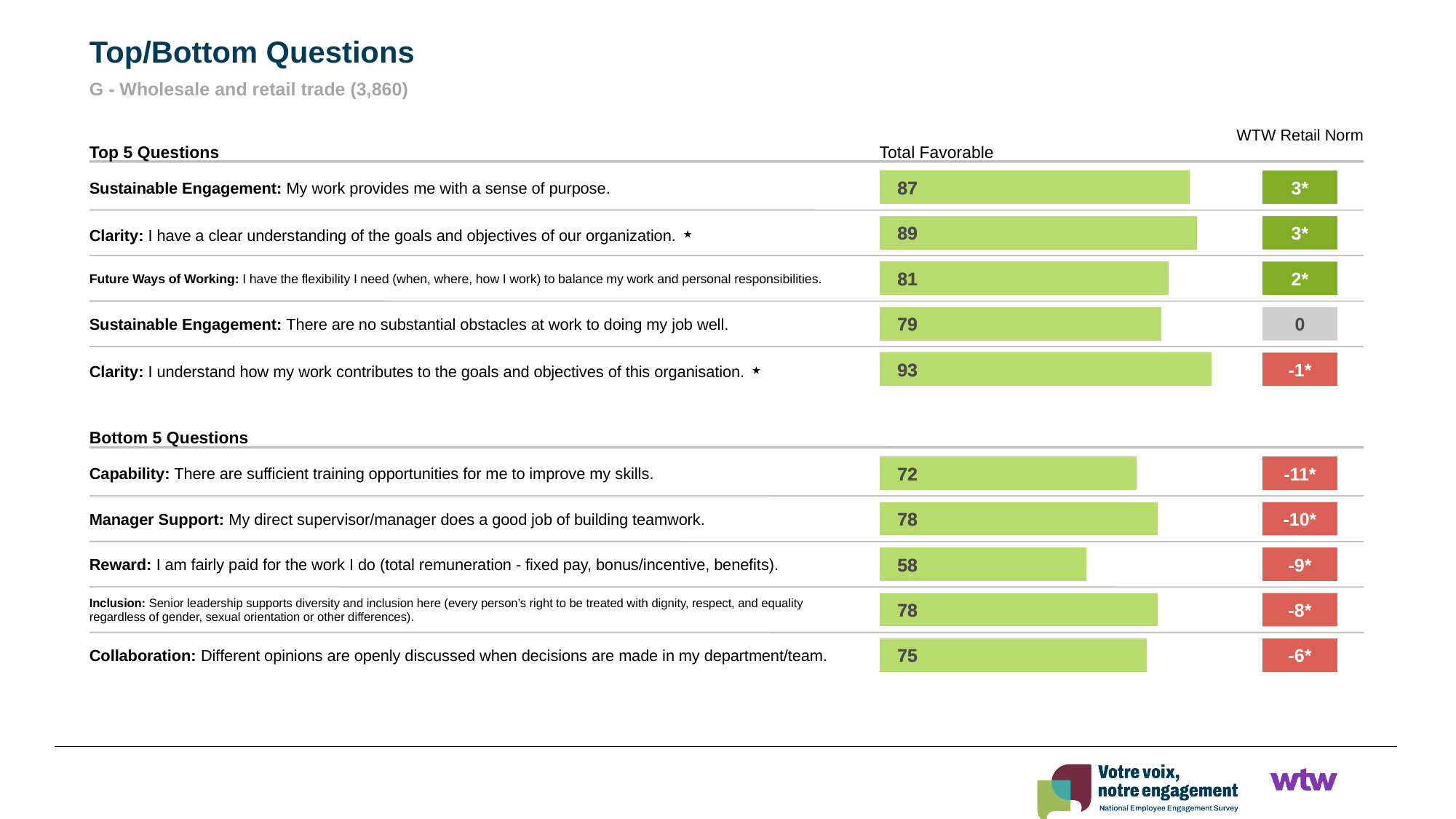
In the Bottom 5 Questions chart, what is the Total Favorable value for "Reward: I am fairly paid for the work I do"? 58 In the Top 5 Questions chart, what is the Total Favorable value for "Future Ways of Working: I have the flexibility I need (when, where, how I work) to balance my work and personal responsibilities"? 81 In the Top 5 Questions chart, what is the Total Favorable value for "Sustainable Engagement: My work provides me with a sense of purpose"? 87 In the Top 5 Questions chart, what is the difference in Total Favorable between "Clarity: I understand how my work contributes to the goals and objectives of this organisation" (93) and "Sustainable Engagement: There are no substantial obstacles at work to doing my job well" (79)? 14 In the Bottom 5 Questions chart, which has a larger Total Favorable value: "Capability: There are sufficient training opportunities for me to improve my skills" or "Collaboration: Different opinions are openly discussed when decisions are made in my department/team"? Collaboration: Different opinions are openly discussed when decisions are made in my department/team. How many questions are listed in the Bottom 5 Questions chart? 5 In the Top 5 Questions chart, what is the WTW Retail Norm value shown for "Sustainable Engagement: There are no substantial obstacles at work to doing my job well"? 0 In the Top 5 Questions chart, which question has the highest Total Favorable value? Clarity: I understand how my work contributes to the goals and objectives of this organisation. In the Bottom 5 Questions chart, which question has the lowest Total Favorable value? Reward: I am fairly paid for the work I do (total remuneration - fixed pay, bonus/incentive, benefits). In the Bottom 5 Questions chart, what is the WTW Retail Norm value shown for "Capability: There are sufficient training opportunities for me to improve my skills"? -11* What is the subtitle shown under the slide title "Top/Bottom Questions"? G - Wholesale and retail trade (3,860) What kind of chart is used to show the Total Favorable values on this slide? Bar chart